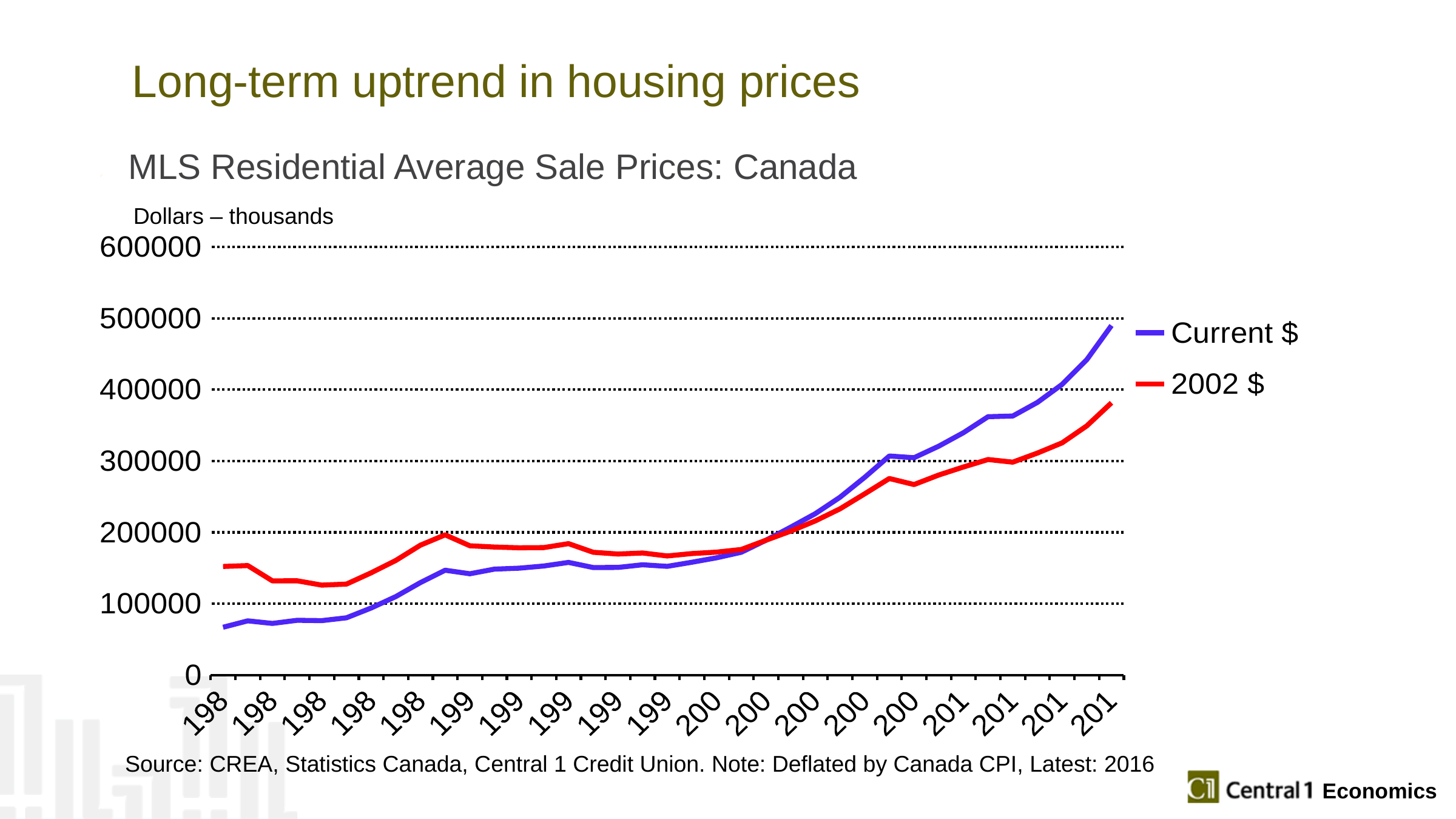
Overall, do the Current $ values rise or fall from the left of the x axis to the right? rise Is the first value of the 2002 $ series greater or less than 100000? greater How many series does the legend list? 2 At the right-hand end of the chart, which series is higher, Current $ or 2002 $? Current $ Which series reaches the highest value on the chart? Current $ Is the final value of the Current $ series greater or less than 500000? less Is the first value of the Current $ series greater or less than 100000? less What are the two series named in the legend? Current $ and 2002 $ At the left-hand end of the chart, which series is higher, Current $ or 2002 $? 2002 $ What is the title of the chart? MLS Residential Average Sale Prices: Canada What kind of chart is shown on the slide? line chart